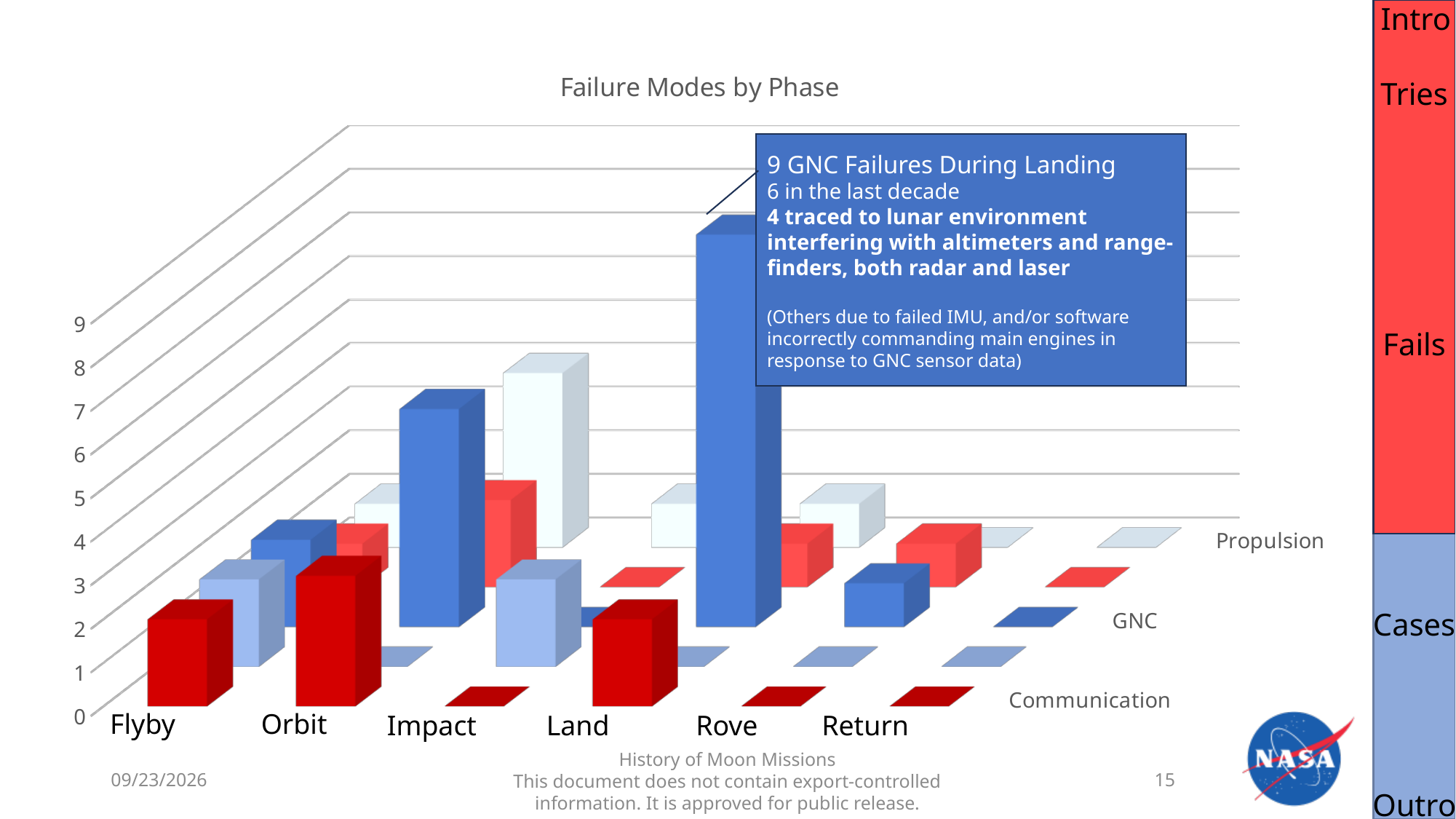
What is the title of the chart? Failure Modes by Phase Which is larger: Communication failures for Flyby or Communication failures for Impact? Flyby How many GNC failures occurred during the Land phase? 9 Which phase has the highest number of Communication failures? Orbit Is the value for Communication failures in the Flyby phase greater or less than 5? less Which is larger: GNC failures for Land or GNC failures for Impact? Land Is the value for GNC failures in the Land phase greater or less than 5? greater Is the value for Communication failures in the Orbit phase greater or less than 6? less How many mission phases are shown along the x axis of the chart? 6 What kind of chart is shown on the slide? bar chart Which phase has the highest number of GNC failures? Land What colour are the Communication bars in the chart? dark red